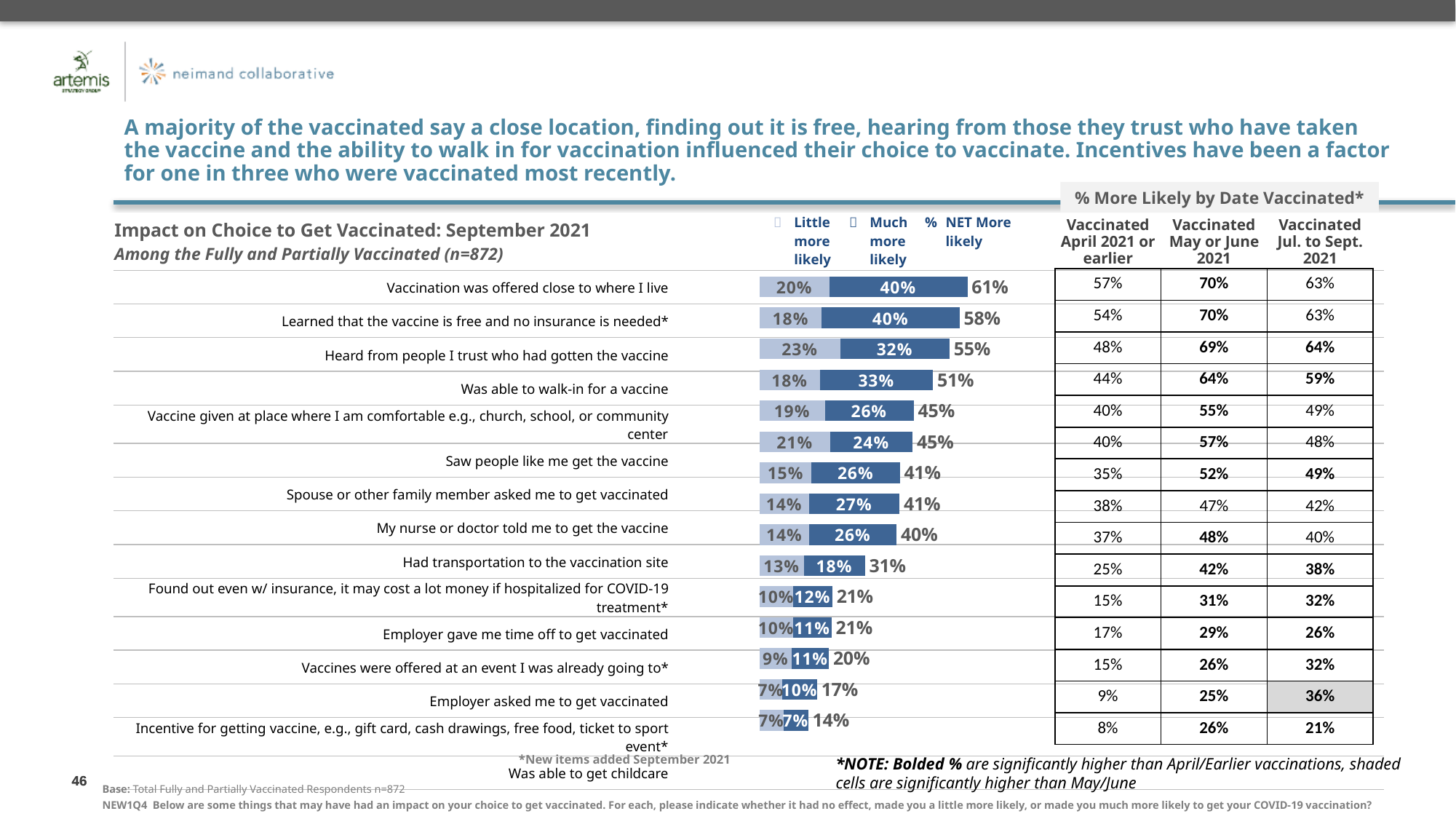
What percentage said "Heard from people I trust who had gotten the vaccine" made them much more likely to get vaccinated? 32% Which has a larger "Little more likely" share: "Heard from people I trust who had gotten the vaccine" or "Vaccination was offered close to where I live"? Heard from people I trust who had gotten the vaccine What kind of chart is shown on the slide? bar chart What is the "Little more likely" value for "Was able to walk-in for a vaccine"? 18% How many items (categories) are plotted in the bar chart? 15 How many entries does the chart legend list? 3 What is the combined total of the "Little more likely" and "Much more likely" segments for "Was able to walk-in for a vaccine"? 51% What is the title of the bar chart? Impact on Choice to Get Vaccinated: September 2021 What is the difference in NET More likely between "Vaccination was offered close to where I live" and "Learned that the vaccine is free and no insurance is needed"? 3 percentage points Which item has the highest NET More likely value? Vaccination was offered close to where I live What is the NET More likely value for "Vaccination was offered close to where I live"? 61% Which item has the lowest NET More likely value? Was able to get childcare